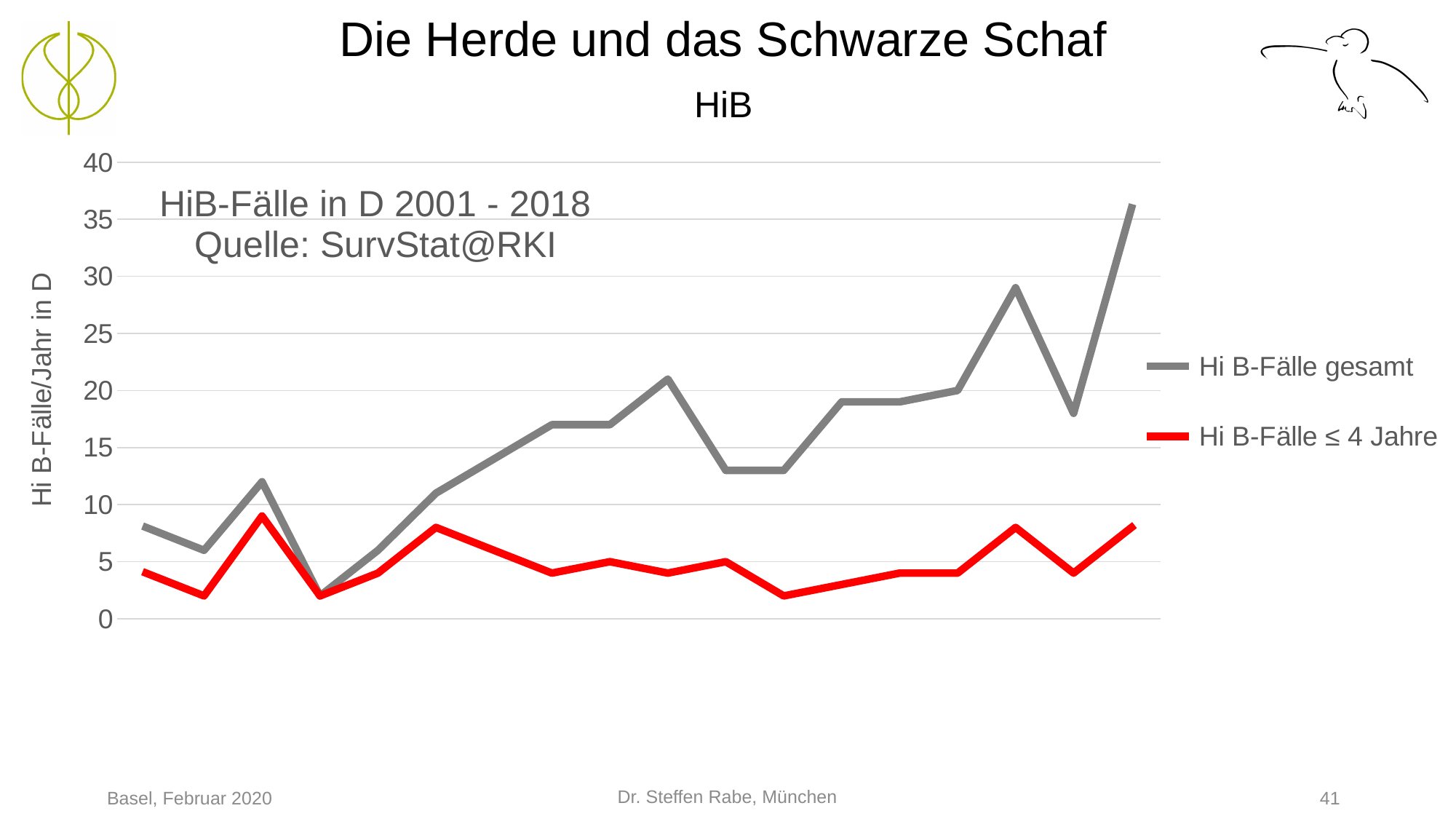
Which series reaches the highest value on the chart? Hi B-Fälle gesamt What is the label of the vertical axis? Hi B-Fälle/Jahr in D Does the Hi B-Fälle gesamt line overall rise or fall from left to right? rise Is the final (rightmost) value of Hi B-Fälle gesamt greater or less than 30? greater How many series does the legend list? 2 At the rightmost point, which series has the larger value, Hi B-Fälle gesamt or Hi B-Fälle ≤ 4 Jahre? Hi B-Fälle gesamt Is the final (rightmost) value of Hi B-Fälle ≤ 4 Jahre greater or less than 10? less Is the first (leftmost) value of Hi B-Fälle gesamt greater or less than 10? less What kind of chart is shown on the slide? line chart What is the title of the chart? HiB-Fälle in D 2001 - 2018 Quelle: SurvStat@RKI Which series is drawn in red? Hi B-Fälle ≤ 4 Jahre